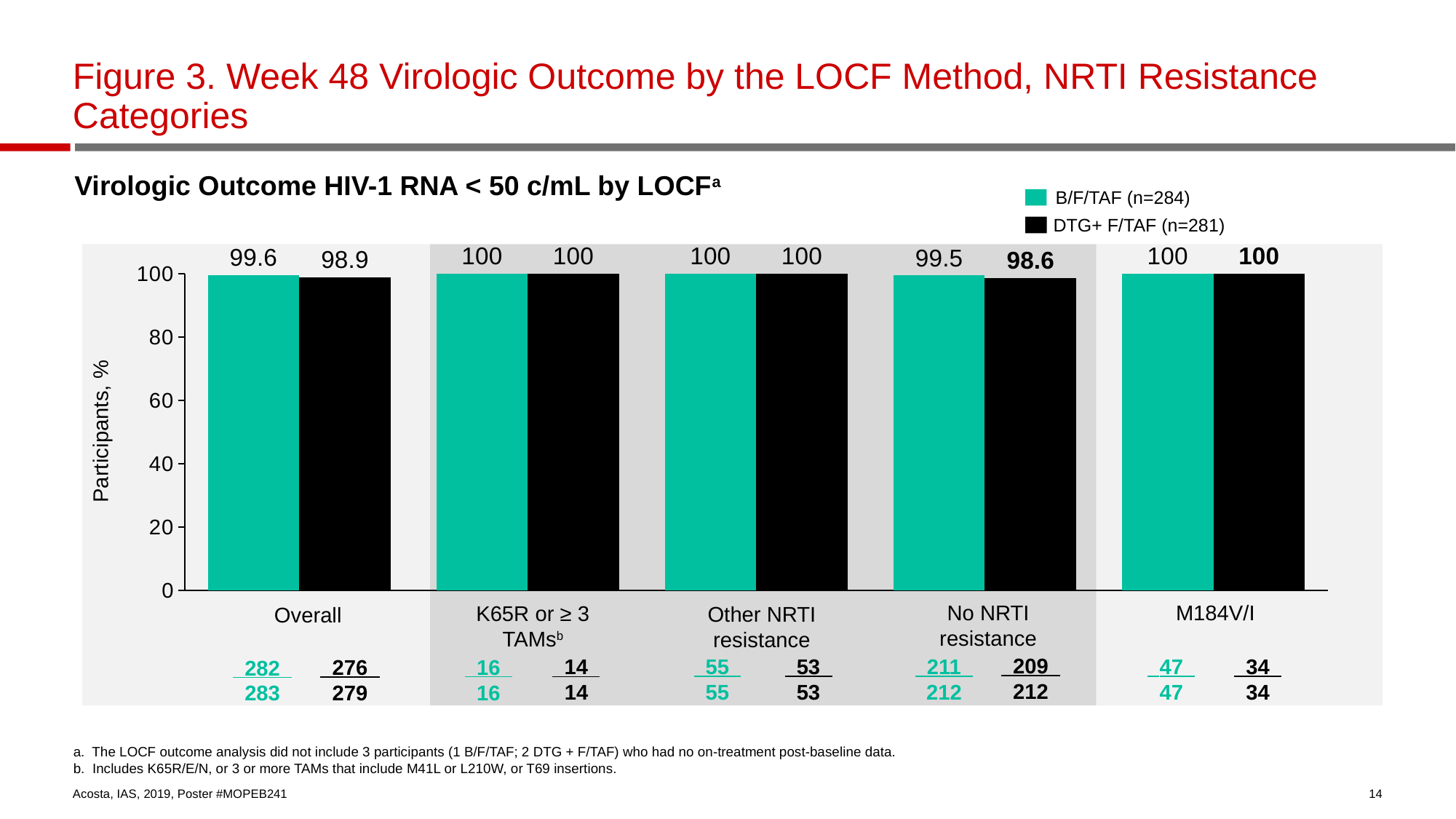
How many series does the legend list? 2 What is the value for B/F/TAF in the Overall category? 99.6 What is the value for DTG+ F/TAF in the No NRTI resistance category? 98.6 What is the label of the y axis? Participants, % What is the difference between the B/F/TAF and DTG+ F/TAF values in the Overall category? 0.7 What is the difference between the B/F/TAF and DTG+ F/TAF values in the No NRTI resistance category? 0.9 Which category has the lowest value for DTG+ F/TAF? No NRTI resistance How many categories are shown on the x axis? 5 What is the value for B/F/TAF in the M184V/I category? 100 What kind of chart is shown? Bar chart What is the value for DTG+ F/TAF in the Overall category? 98.9 What is the value for B/F/TAF in the No NRTI resistance category? 99.5